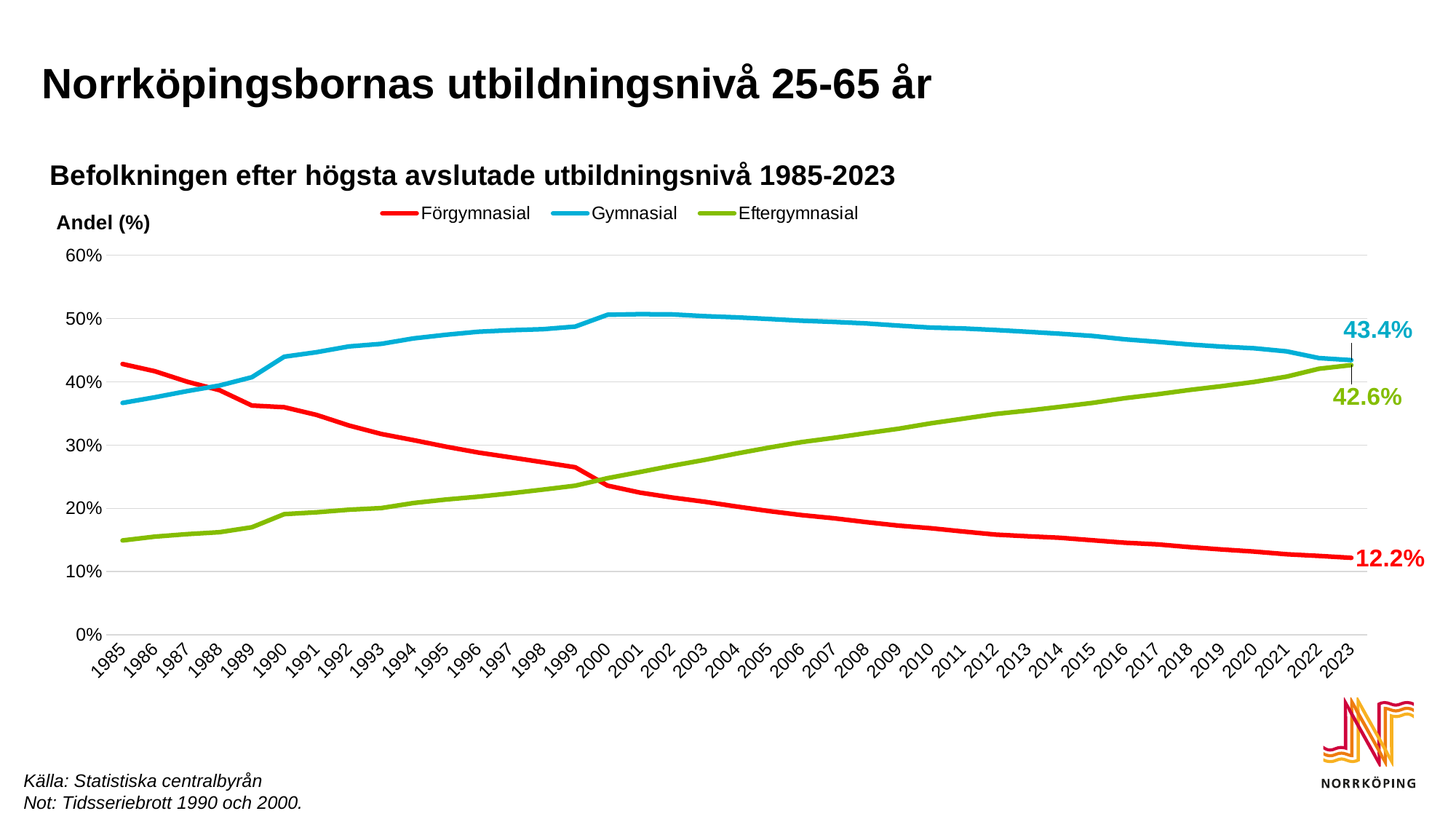
How many series does the legend list? 3 What is the value for Gymnasial in 2023? 43.4% What is the value for Förgymnasial in 2023? 12.2% Which series has the lowest value in 2023? Förgymnasial Does the Förgymnasial series rise or fall from 1985 to 2023? Fall What is the difference between the Gymnasial and Förgymnasial values in 2023? 31.2 percentage points Is the value for Eftergymnasial in 1985 greater or less than 20%? less What is the value for Eftergymnasial in 2023? 42.6% What kind of chart is shown on the slide? Line chart Is the value for Gymnasial in 2001 greater or less than 40%? greater In 1985, which is larger: Förgymnasial or Eftergymnasial? Förgymnasial What is the difference between the Gymnasial and Eftergymnasial values in 2023? 0.8 percentage points